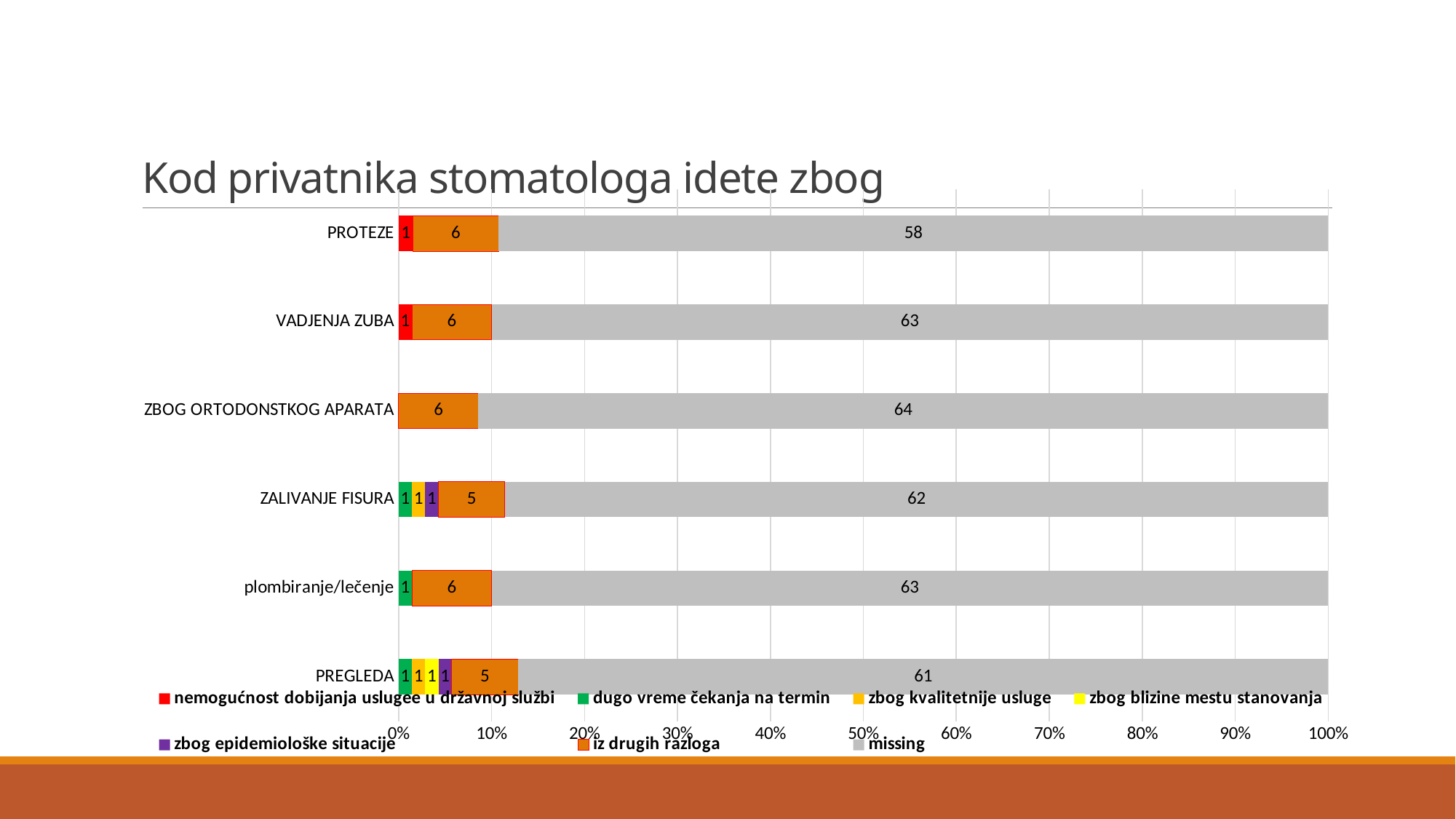
What is the title of the chart? Kod privatnika stomatologa idete zbog What is the total of all segments in the PROTEZE bar? 65 Which category has the highest 'missing' value? ZBOG ORTODONSTKOG APARATA What is the difference between the 'missing' values for VADJENJA ZUBA and PROTEZE? 5 What kind of chart is shown on the slide? Stacked bar chart Which category has the lowest 'missing' value? PROTEZE How many categories are shown on the chart? 6 What is the value of the 'missing' segment for ZBOG ORTODONSTKOG APARATA? 64 Which is larger, the 'iz drugih razloga' value for PREGLEDA or for plombiranje/lečenje? plombiranje/lečenje What is the value of the 'missing' segment for PROTEZE? 58 How many series does the legend list? 7 What is the value of the 'iz drugih razloga' segment for ZALIVANJE FISURA? 5